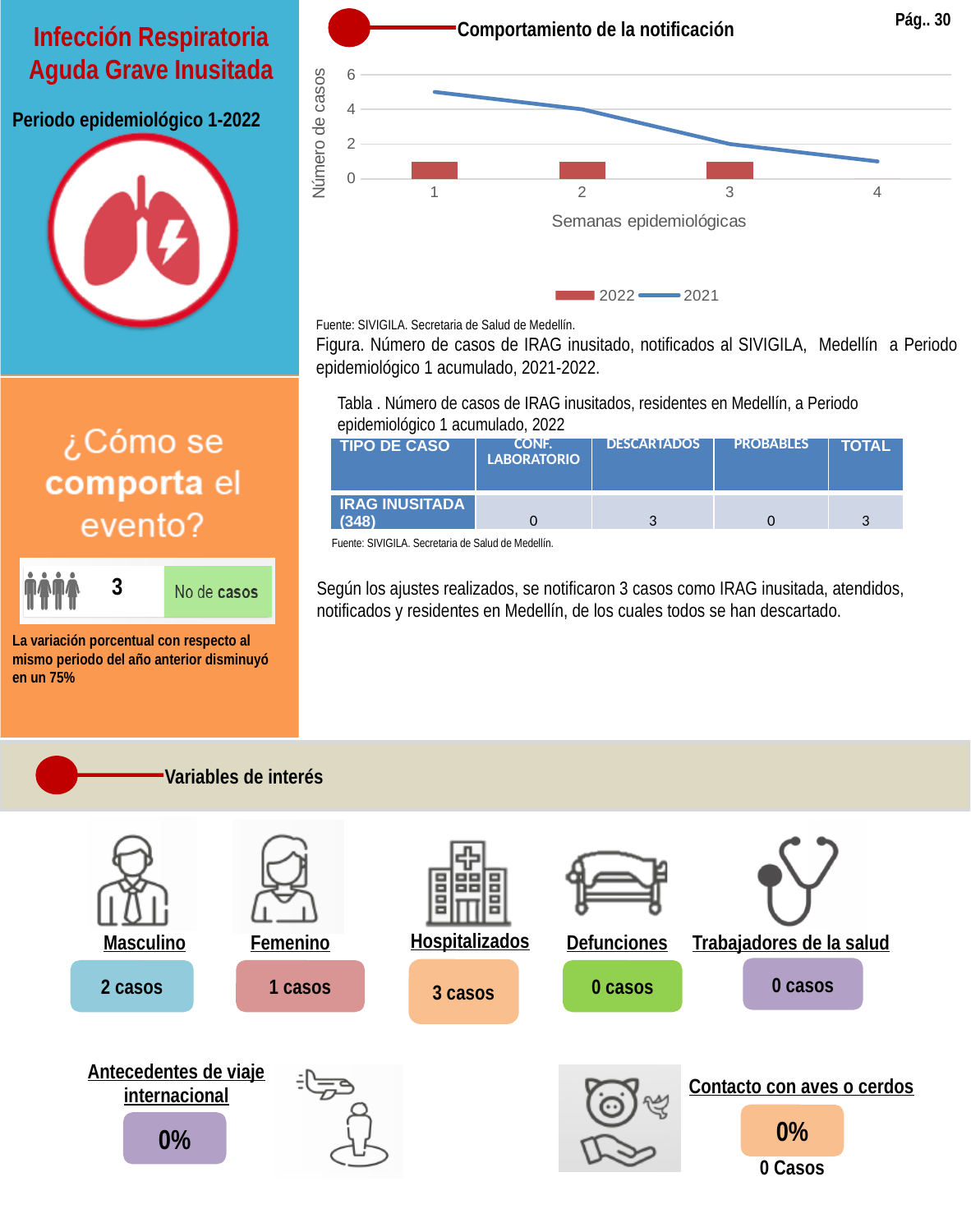
Is the 2021 value for week 1 greater or less than 4? greater How many series does the chart legend list? 2 In which week is the 2021 value lowest? 4 In week 1, which series has the larger value, 2021 or 2022? 2021 Is the 2021 value for week 4 greater or less than 2? less What is the label of the y axis of the chart? Número de casos How many epidemiological weeks are shown on the x axis of the chart? 4 Does the 2021 line rise or fall from week 1 to week 4? fall Which series is drawn as a line in the chart? 2021 In which week is the 2021 value highest? 1 What is the title of the chart on the slide? Comportamiento de la notificación Is the 2022 value for week 2 greater or less than 2? less